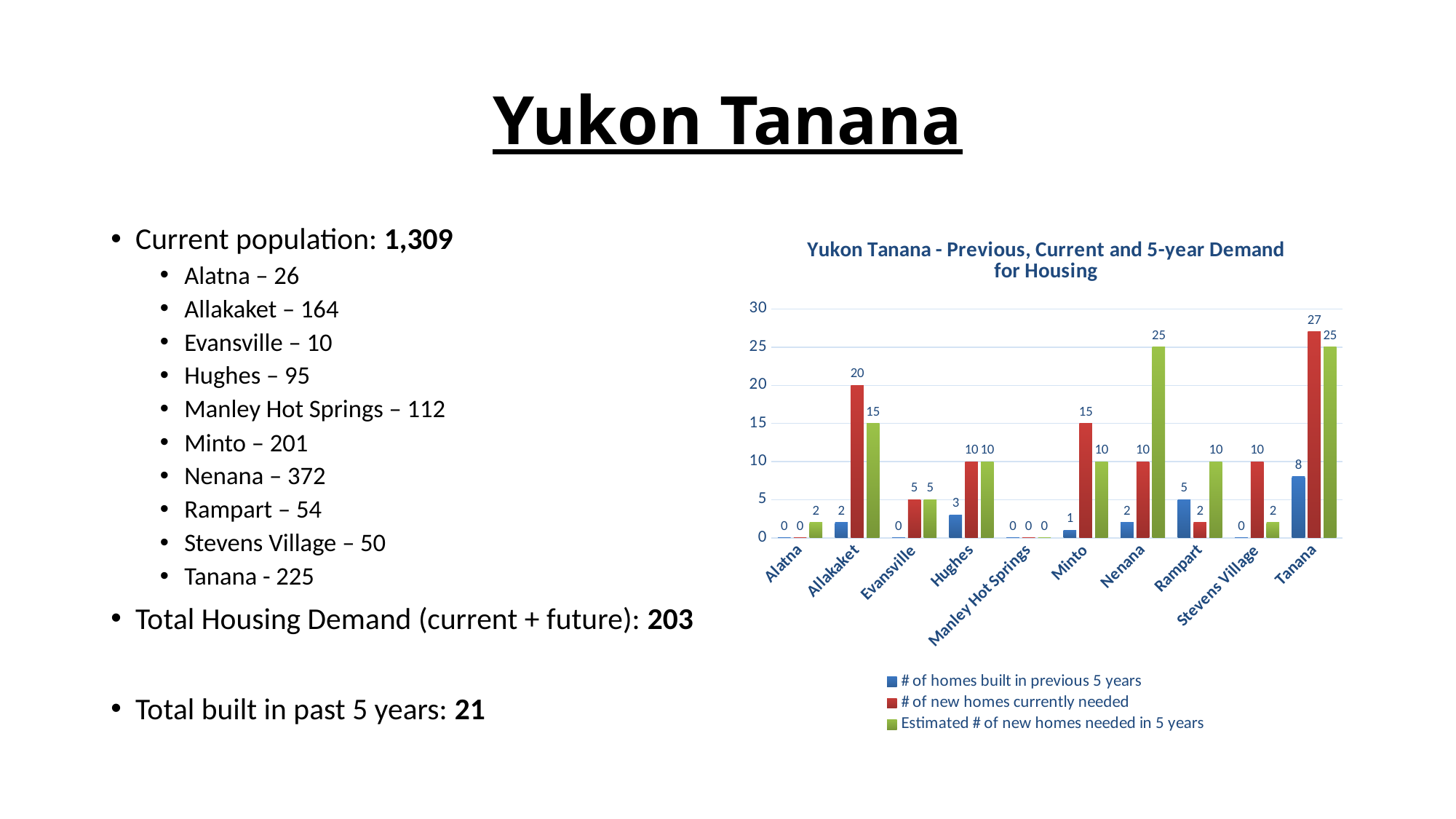
How many homes were built in the previous 5 years in Rampart? 5 What is the title of the chart? Yukon Tanana - Previous, Current and 5-year Demand for Housing Which community has the highest number of new homes currently needed? Tanana What type of chart is shown on the slide? bar chart How many communities are shown on the x axis of the chart? 10 What is the estimated number of new homes needed in 5 years for Nenana? 25 Which community has the highest number of homes built in the previous 5 years? Tanana What is the number of new homes currently needed in Tanana? 27 What is the difference between the number of new homes currently needed in Allakaket and the estimated number needed in 5 years there? 5 How many series does the chart legend list? 3 Which is larger for Minto: the number of new homes currently needed or the estimated number needed in 5 years? # of new homes currently needed What is the number of new homes currently needed in Stevens Village? 10